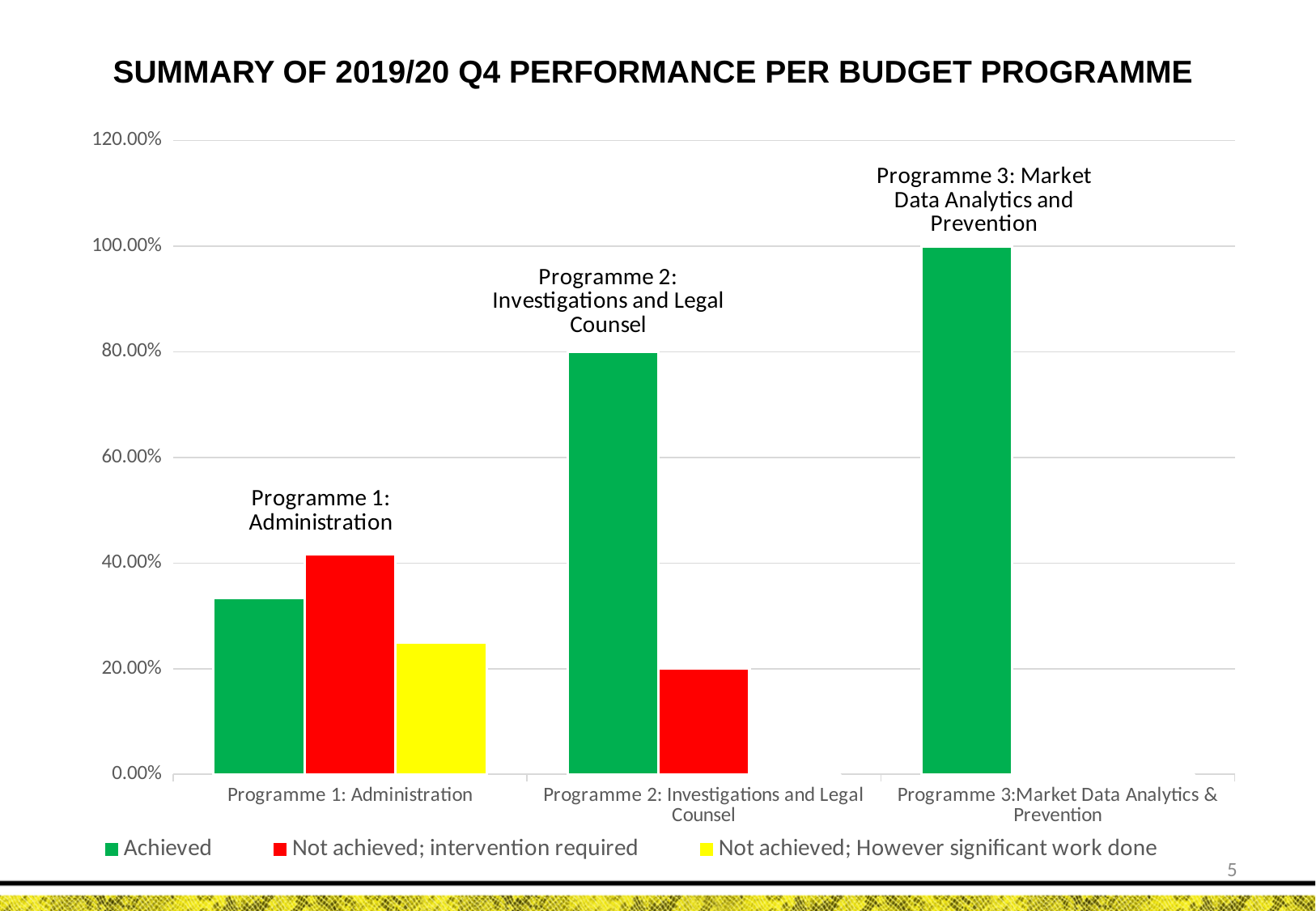
Is the 'Not achieved; intervention required' value for Programme 2: Investigations and Legal Counsel greater or less than 40.00%? less For Programme 1: Administration, which is larger: the Achieved bar or the 'Not achieved; intervention required' bar? Not achieved; intervention required What kind of chart is shown on the slide? Bar chart Is the Achieved value for Programme 3: Market Data Analytics & Prevention greater or less than 80.00%? greater What is the title of the chart? SUMMARY OF 2019/20 Q4 PERFORMANCE PER BUDGET PROGRAMME Is the Achieved value for Programme 1: Administration greater or less than 40.00%? less Which programme has the lowest Achieved bar? Programme 1: Administration How many budget programmes are shown on the x axis? 3 What colour represents the 'Not achieved; However significant work done' series? Yellow Which is larger: the Achieved bar for Programme 2 or the 'Not achieved; intervention required' bar for Programme 1? Achieved bar for Programme 2 Which programme has the highest Achieved bar? Programme 3: Market Data Analytics & Prevention How many series does the legend list? 3